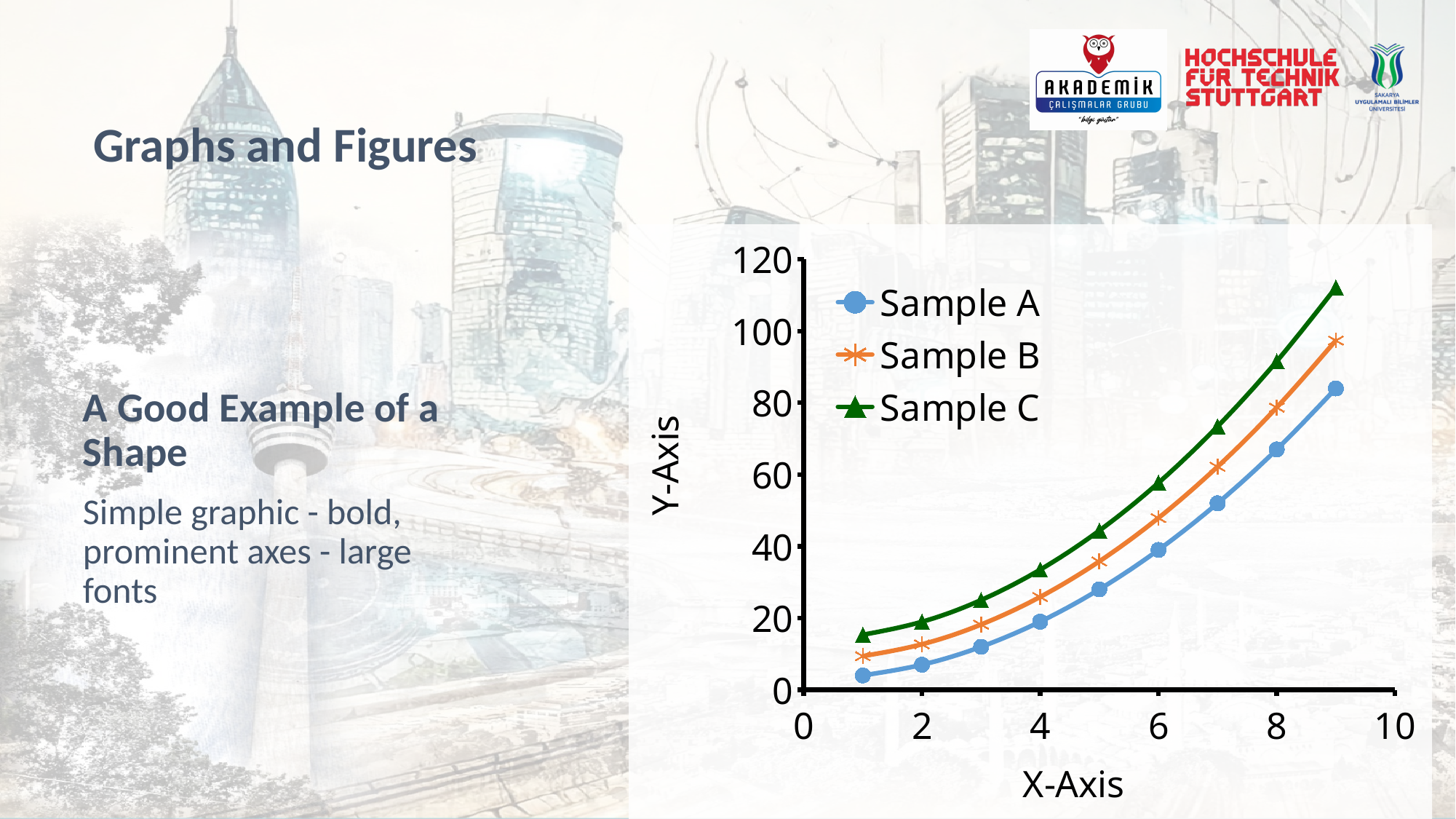
Do the values for Sample C rise or fall as the x axis increases? rise At x = 9, which is larger, the value for Sample C or the value for Sample A? Sample C How many series does the legend list? 3 How many data points are plotted for Sample A? 9 At x = 5, is the value for Sample A greater or less than 40? less What kind of chart is shown on the slide? line chart Which series has the highest value at x = 9? Sample C Which series has the lowest value at x = 9? Sample A At x = 9, is the value for Sample A greater or less than 100? less What is the title of the vertical axis of the chart? Y-Axis At x = 9, is the value for Sample C greater or less than 100? greater